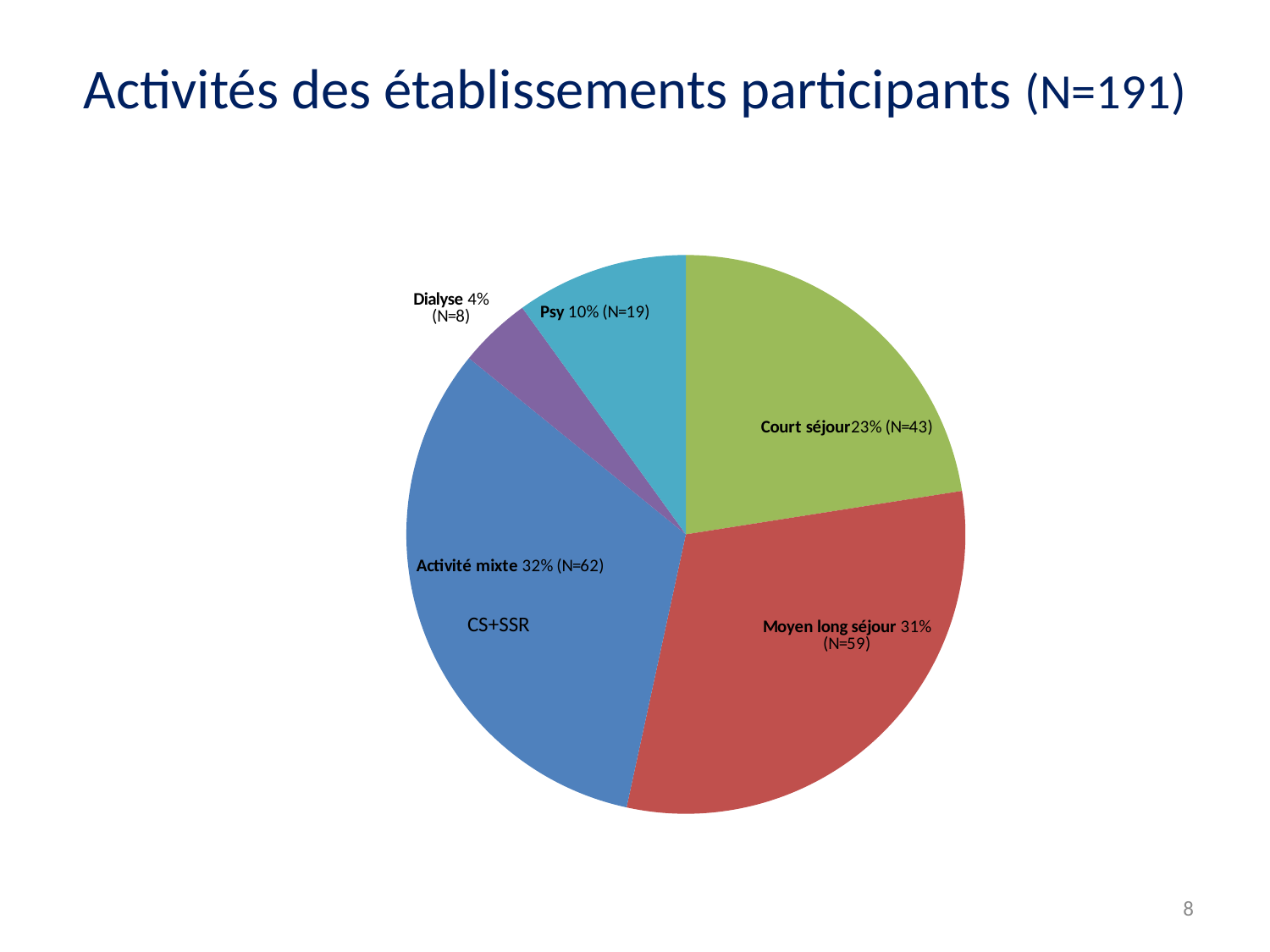
Which is larger, the Psy slice or the Dialyse slice? Psy What is the N value for Moyen long séjour? N=59 What is the percentage share of the Dialyse slice? 4% How many slices does the pie chart have? 5 What is the difference in N between Activité mixte and Court séjour? 19 What is the N value for Psy? N=19 Which category has the smallest slice? Dialyse What percentage share does the Court séjour slice have? 23% What kind of chart is shown on the slide? pie chart Which category has the largest slice? Activité mixte What percentage share does the Activité mixte slice have? 32% What is the title of the chart on the slide? Activités des établissements participants (N=191)